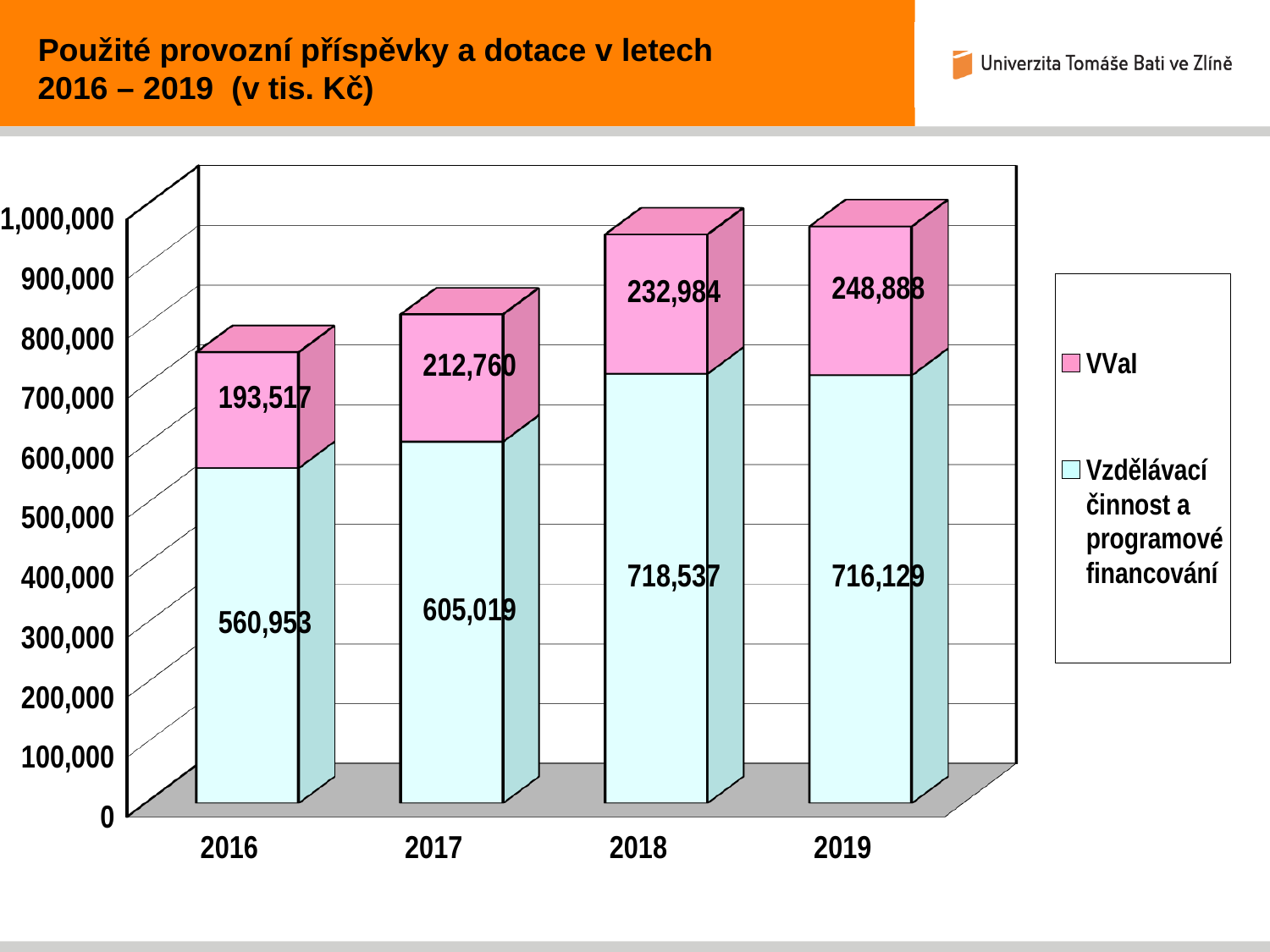
What is the difference between the Vzdělávací činnost a programové financování values for 2018 and 2017? 113,518 What is the total of the stacked bar for 2016? 754,470 Which is larger: the VVaI value in 2018 or in 2017? 2018 In which year is the VVaI value the highest? 2019 What is the value for Vzdělávací činnost a programové financování in 2018? 718,537 What is the value for VVaI in 2017? 212,760 What is the total of the stacked bar for 2019? 965,017 What type of chart is shown on the slide? Stacked bar chart How many series does the legend list? 2 What is the value for VVaI in 2016? 193,517 What is the difference between the VVaI values for 2019 and 2016? 55,371 In which year is the Vzdělávací činnost a programové financování value the lowest? 2016